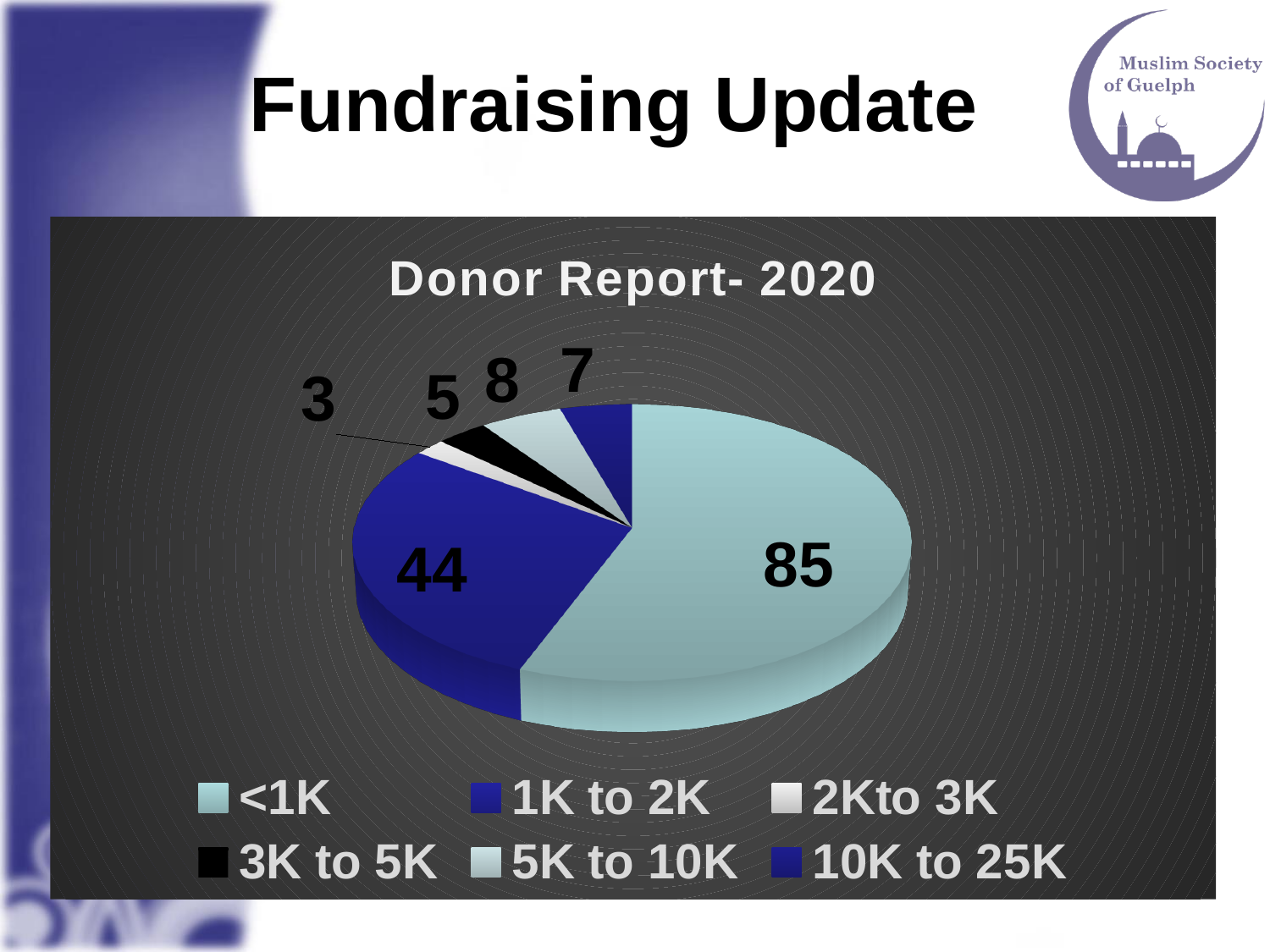
What is the title of the chart? Donor Report- 2020 How many slices does the pie chart have? 6 What is the value for the <1K slice? 85 What is the value for the 5K to 10K slice? 8 What is the value for the 2K to 3K slice? 3 Which category has the largest slice? <1K What is the total of all the slice values in the pie chart? 152 What kind of chart is shown on the slide? Pie chart Which category has the smallest slice? 2K to 3K Which is larger, the 5K to 10K slice or the 10K to 25K slice? 5K to 10K What is the difference between the <1K value and the 1K to 2K value? 41 What is the value for the 1K to 2K slice? 44